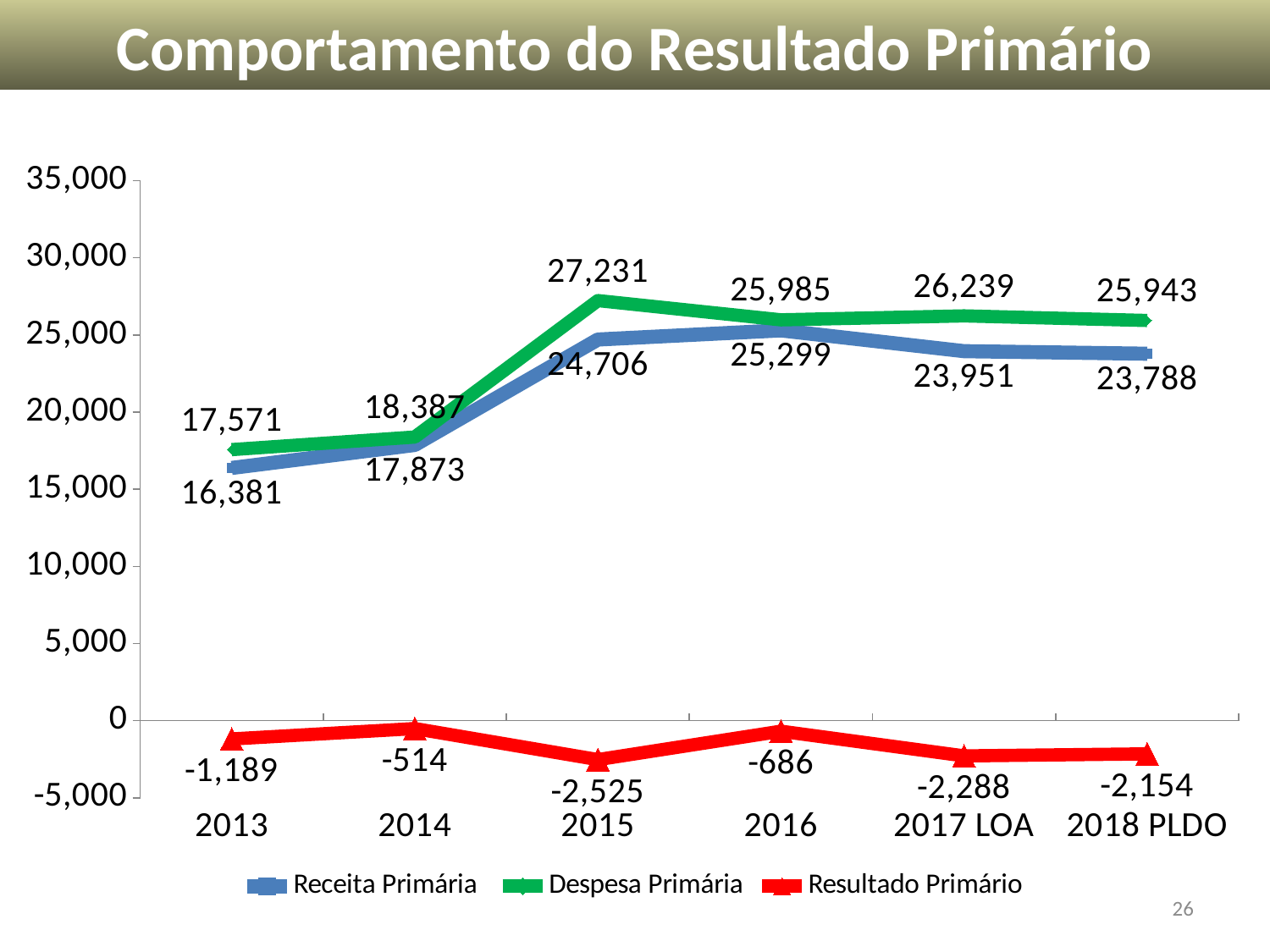
What is the value of Receita Primária in 2013? 16,381 Does Receita Primária rise or fall from 2013 to 2015? rise How many series does the legend list? 3 What is the difference between Despesa Primária and Receita Primária in 2016? 686 What is the value of Despesa Primária in 2015? 27,231 What type of chart is shown on the slide? line chart In which year is Despesa Primária highest? 2015 How many categories are shown on the x axis? 6 What is the value of Resultado Primário for 2018 PLDO? -2,154 Which is larger in 2017 LOA, Receita Primária or Despesa Primária? Despesa Primária What is the title of the chart? Comportamento do Resultado Primário In which category is Resultado Primário lowest? 2015